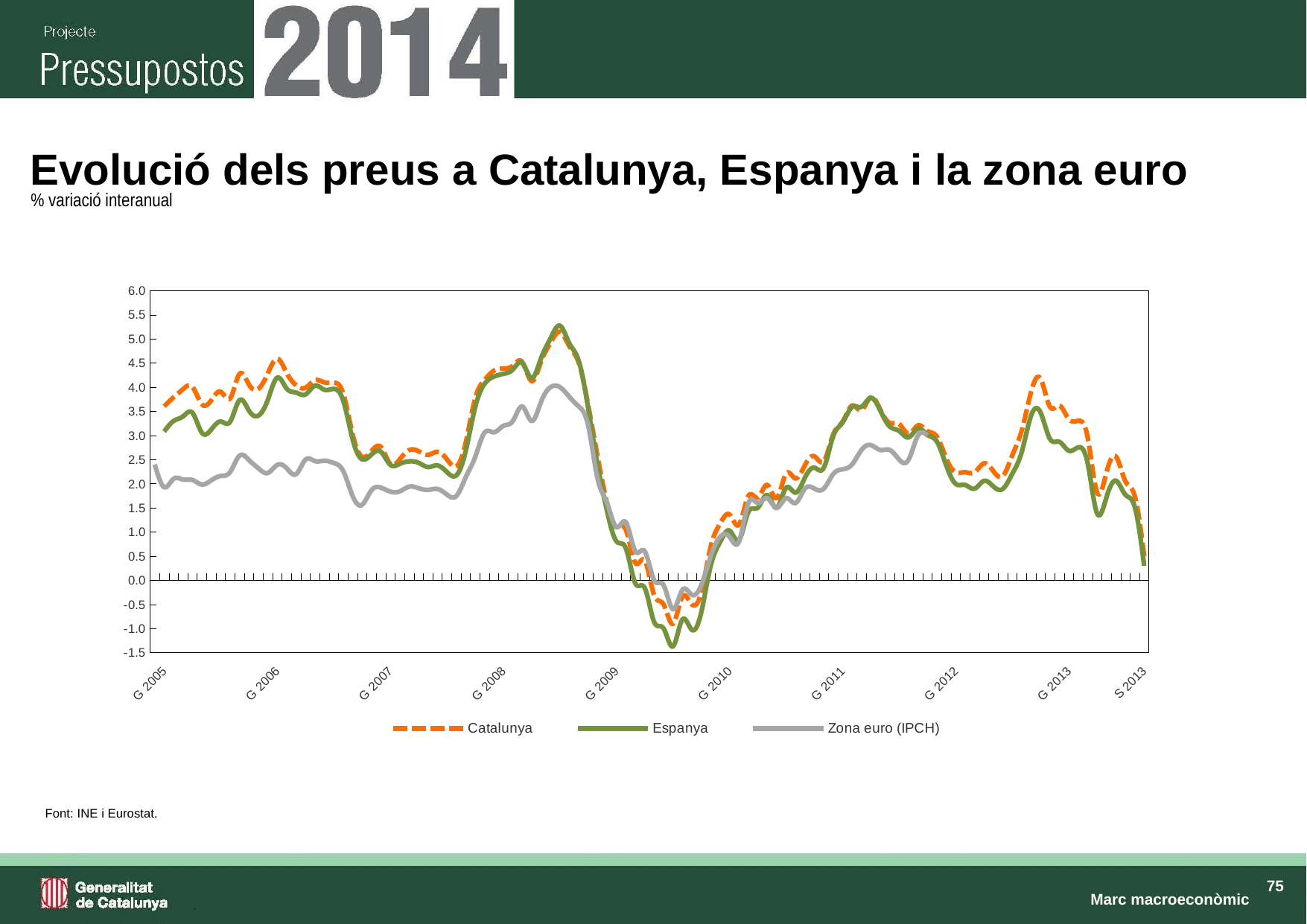
What kind of chart is shown on the slide? line chart Is the lowest value reached by Espanya during 2009 greater or less than -1.0? less Does the value for Espanya rise or fall between G 2008 and G 2009? fall How many series does the legend list? 3 Is the value for Catalunya at G 2005 greater or less than 3.0? greater At G 2005, which is larger: the value for Catalunya or the value for Zona euro (IPCH)? Catalunya Which series is drawn with a dashed orange line? Catalunya Which series reaches the lowest value during 2009? Espanya What is the title of the chart? Evolució dels preus a Catalunya, Espanya i la zona euro Is the value for Espanya at S 2013 greater or less than 1.0? less How many labels are shown on the x axis? 10